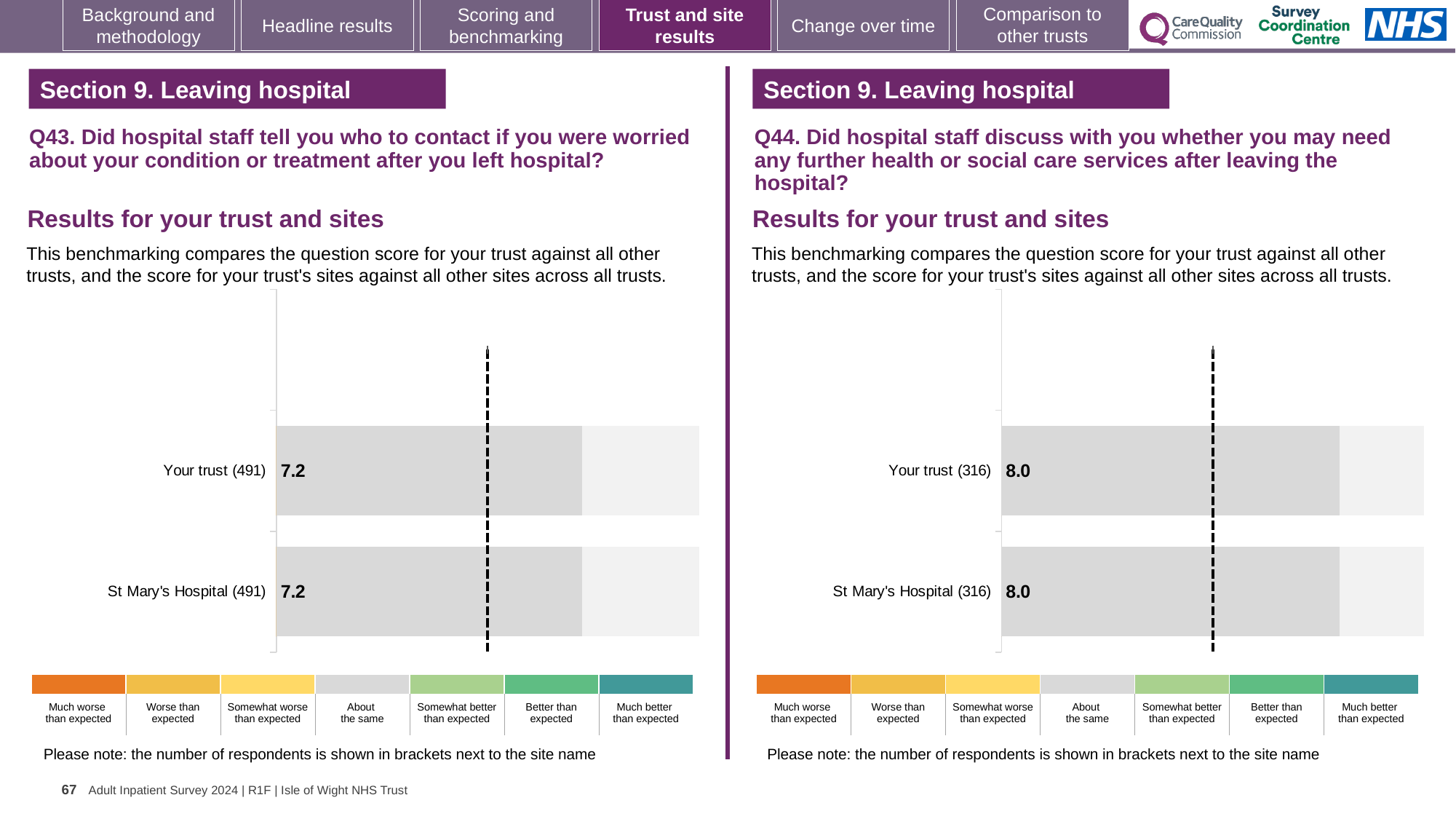
On the right chart (Q44), what is the difference between the score for Your trust and the score for St Mary's Hospital? 0.0 On the left chart (Q43), what is the score for Your trust? 7.2 How many bars are plotted on the left chart (Q43)? 2 On the right chart (Q44), how many respondents are shown in brackets for St Mary's Hospital? 316 On the left chart (Q43), how many respondents are shown in brackets for Your trust? 491 How many bars are plotted on the right chart (Q44)? 2 On the right chart (Q44), what is the score for St Mary's Hospital? 8.0 What kind of chart is used on the left (Q43)? Bar chart On the left chart (Q43), what is the difference between the score for Your trust and the score for St Mary's Hospital? 0.0 On the right chart (Q44), what is the score for Your trust? 8.0 Is the score for Your trust on the right chart (Q44) larger or smaller than the score for Your trust on the left chart (Q43)? Larger On the left chart (Q43), what is the score for St Mary's Hospital? 7.2